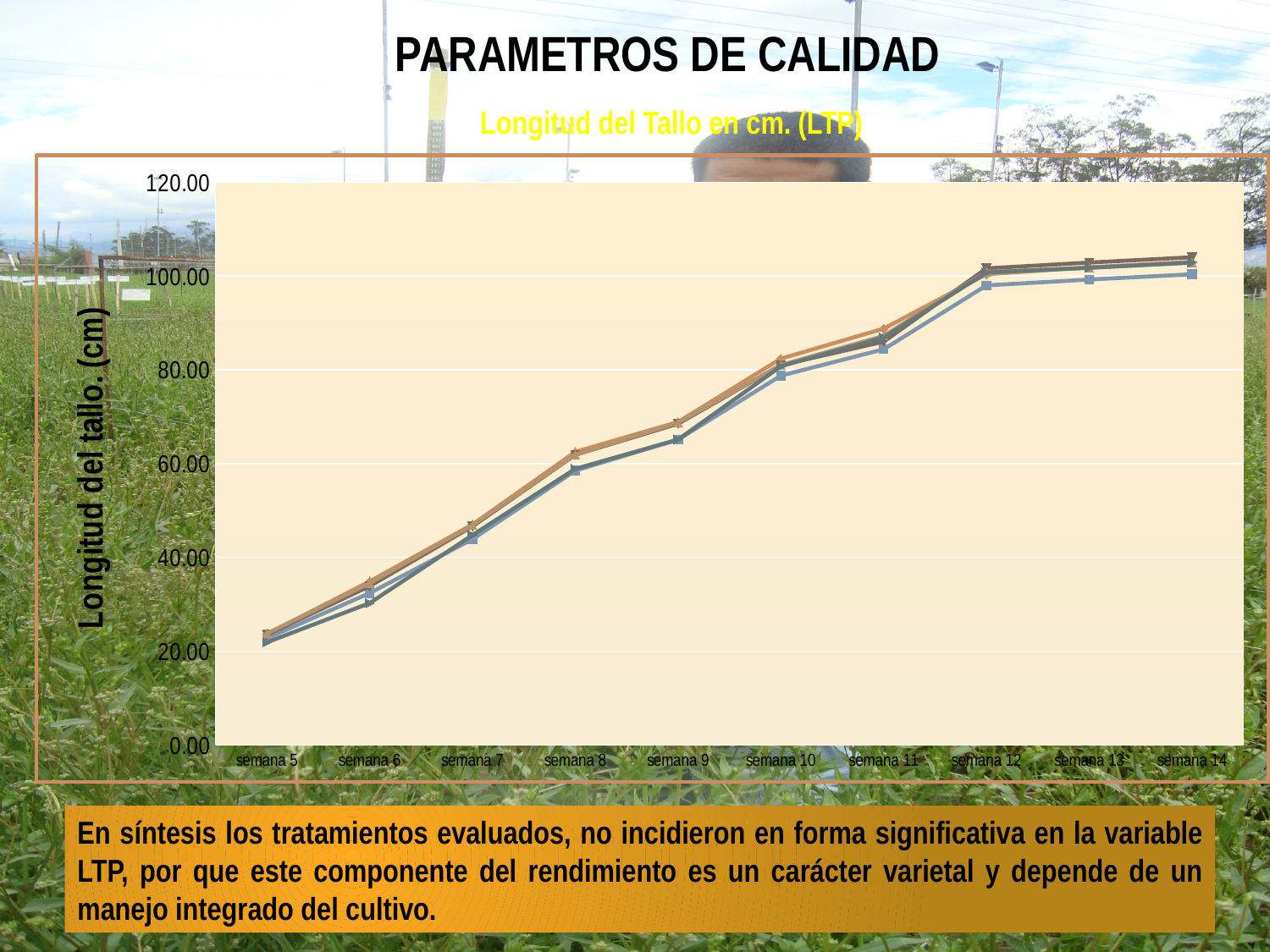
Are the values for semana 5 greater or less than 40.00? less At which week are the plotted values lowest? semana 5 What is the title of the chart? Longitud del Tallo en cm. (LTP) Are the values for semana 8 greater or less than 40.00? greater How many weeks (categories) are plotted along the x axis? 10 What kind of chart is shown on the slide? line chart Are the values for semana 11 greater or less than 100.00? less What is the label of the vertical axis? Longitud del tallo. (cm) At which week are the plotted values highest? semana 14 Do the values rise or fall from semana 5 to semana 14? rise Which week has larger values, semana 9 or semana 6? semana 9